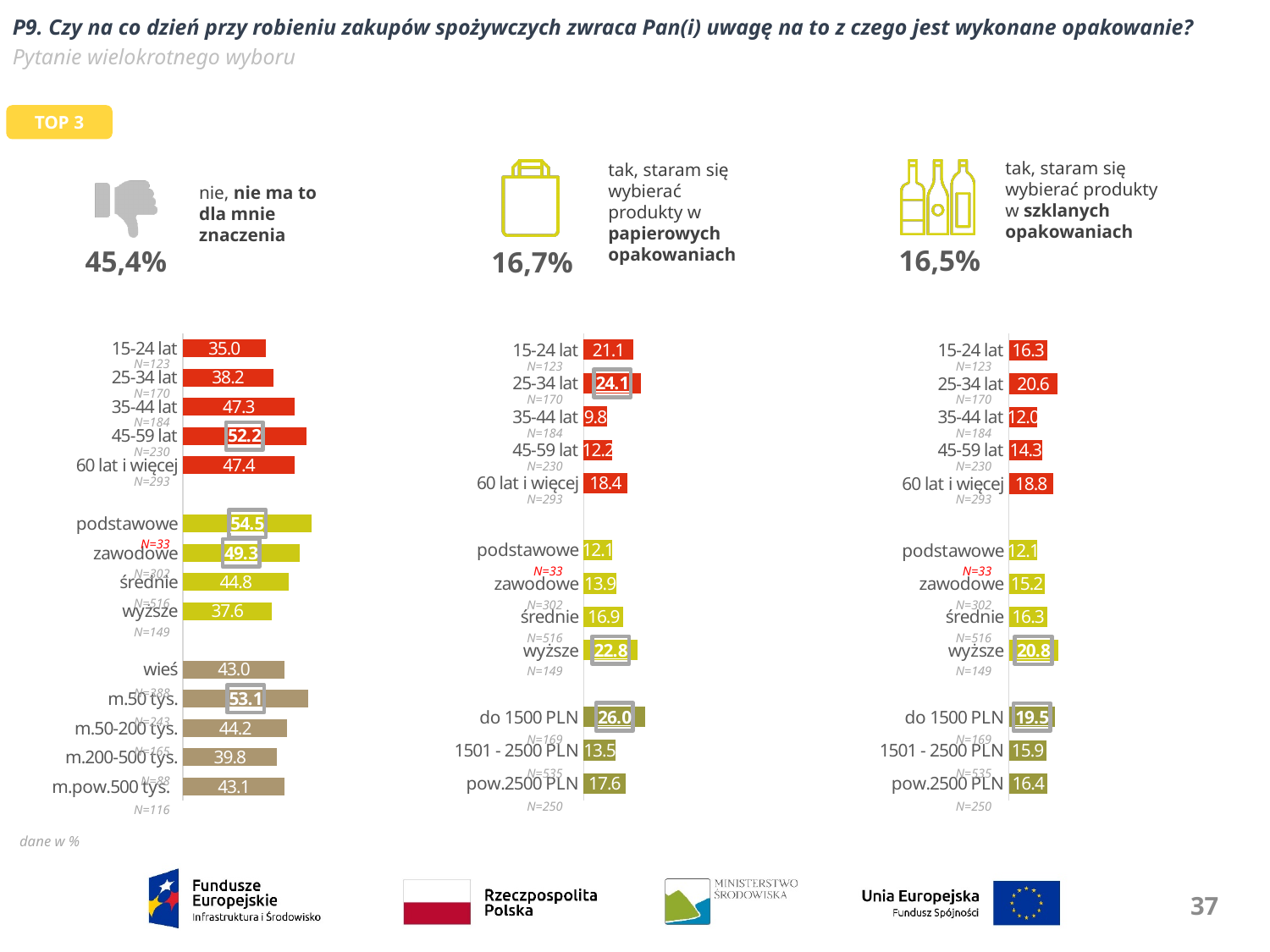
In the left chart (nie, nie ma to dla mnie znaczenia), what is the value for 45-59 lat? 52.2 In the right chart (szklanych opakowaniach), what is the value for wyższe? 20.8 In the left chart (nie, nie ma to dla mnie znaczenia), what is the difference between m.50 tys. and wieś? 10.1 In the left chart (nie, nie ma to dla mnie znaczenia), which category has the lowest value? 15-24 lat In the middle chart (papierowych opakowaniach), which category has the lowest value? 35-44 lat In the right chart (szklanych opakowaniach), which age group has the lowest value? 35-44 lat In the right chart (szklanych opakowaniach), what is the difference between 25-34 lat and 15-24 lat? 4.3 In the left chart (nie, nie ma to dla mnie znaczenia), which category has the highest value? podstawowe In the middle chart (papierowych opakowaniach), which is larger: 25-34 lat or 60 lat i więcej? 25-34 lat What type of chart is used on this slide? bar chart In the middle chart (papierowych opakowaniach), what is the value for do 1500 PLN? 26.0 How many categories are plotted in the left chart (nie, nie ma to dla mnie znaczenia)? 14